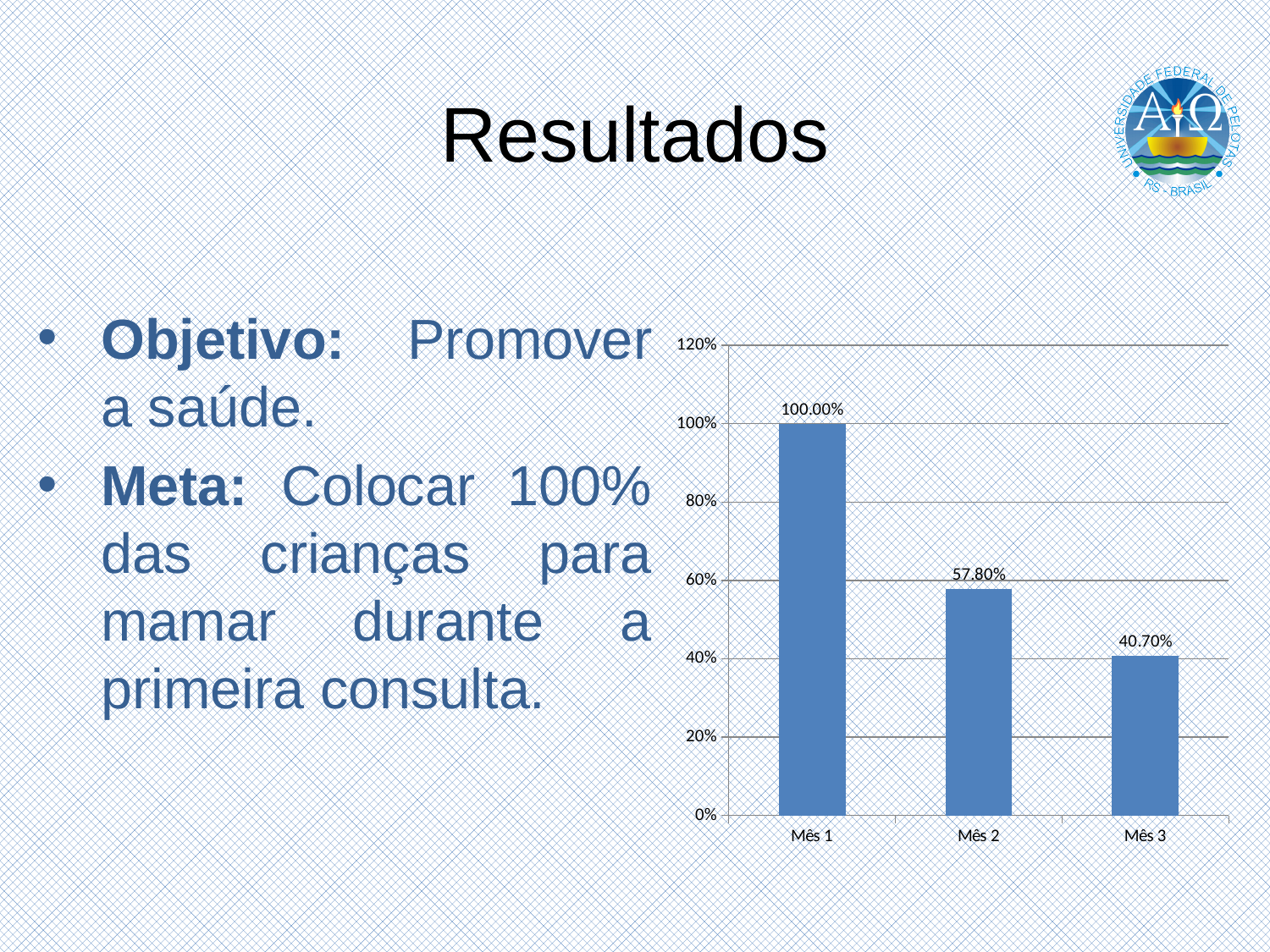
What is the value for Mês 1? 100.00% How many categories are shown on the x axis? 3 Which is larger, the value for Mês 2 or the value for Mês 3? Mês 2 Do the values rise or fall from Mês 1 to Mês 3? fall Is the value for Mês 3 greater or less than 60%? less What is the value for Mês 2? 57.80% Which month has the highest value? Mês 1 What is the value for Mês 3? 40.70% Which month has the lowest value? Mês 3 What is the difference between the values for Mês 1 and Mês 2? 42.20% What is the difference between the values for Mês 2 and Mês 3? 17.10% What kind of chart is shown on the slide? bar chart